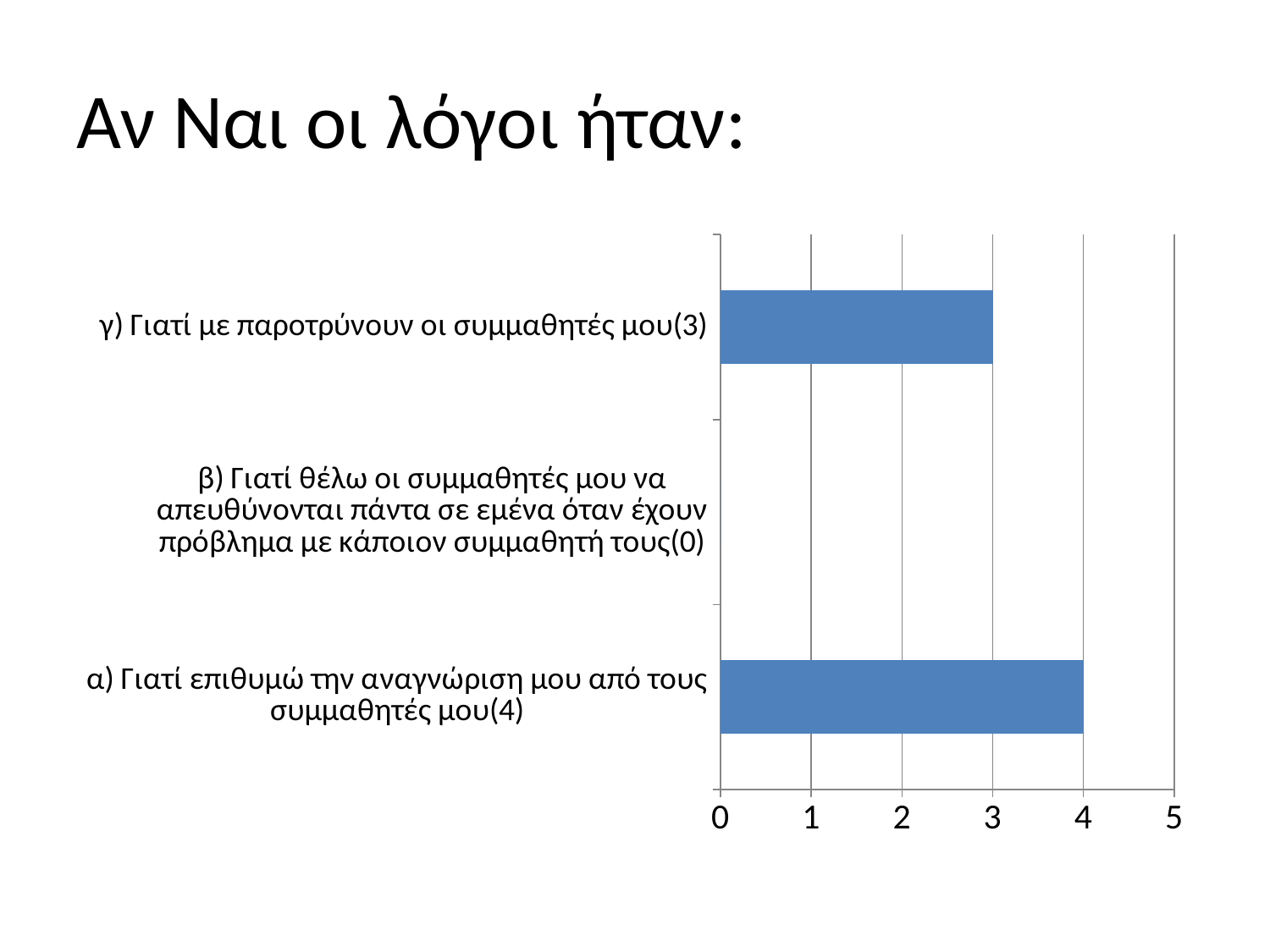
What is the difference between the value for category α) and the value for category γ)? 1 What is the maximum value shown on the horizontal axis? 5 What is the title of the slide containing the chart? Αν Ναι οι λόγοι ήταν: Is the value for category γ) greater or less than 2? greater How many categories does the chart show? 3 What is the value for "γ) Γιατί με παροτρύνουν οι συμμαθητές μου"? 3 What is the value for "α) Γιατί επιθυμώ την αναγνώριση μου από τους συμμαθητές μου"? 4 What kind of chart is shown on the slide? bar chart What is the value for "β) Γιατί θέλω οι συμμαθητές μου να απευθύνονται πάντα σε εμένα όταν έχουν πρόβλημα με κάποιον συμμαθητή τους"? 0 Which category has the lowest value? β) Γιατί θέλω οι συμμαθητές μου να απευθύνονται πάντα σε εμένα όταν έχουν πρόβλημα με κάποιον συμμαθητή τους Which category has the highest value? α) Γιατί επιθυμώ την αναγνώριση μου από τους συμμαθητές μου Which is larger, the value for category α) or the value for category γ)? α) Γιατί επιθυμώ την αναγνώριση μου από τους συμμαθητές μου